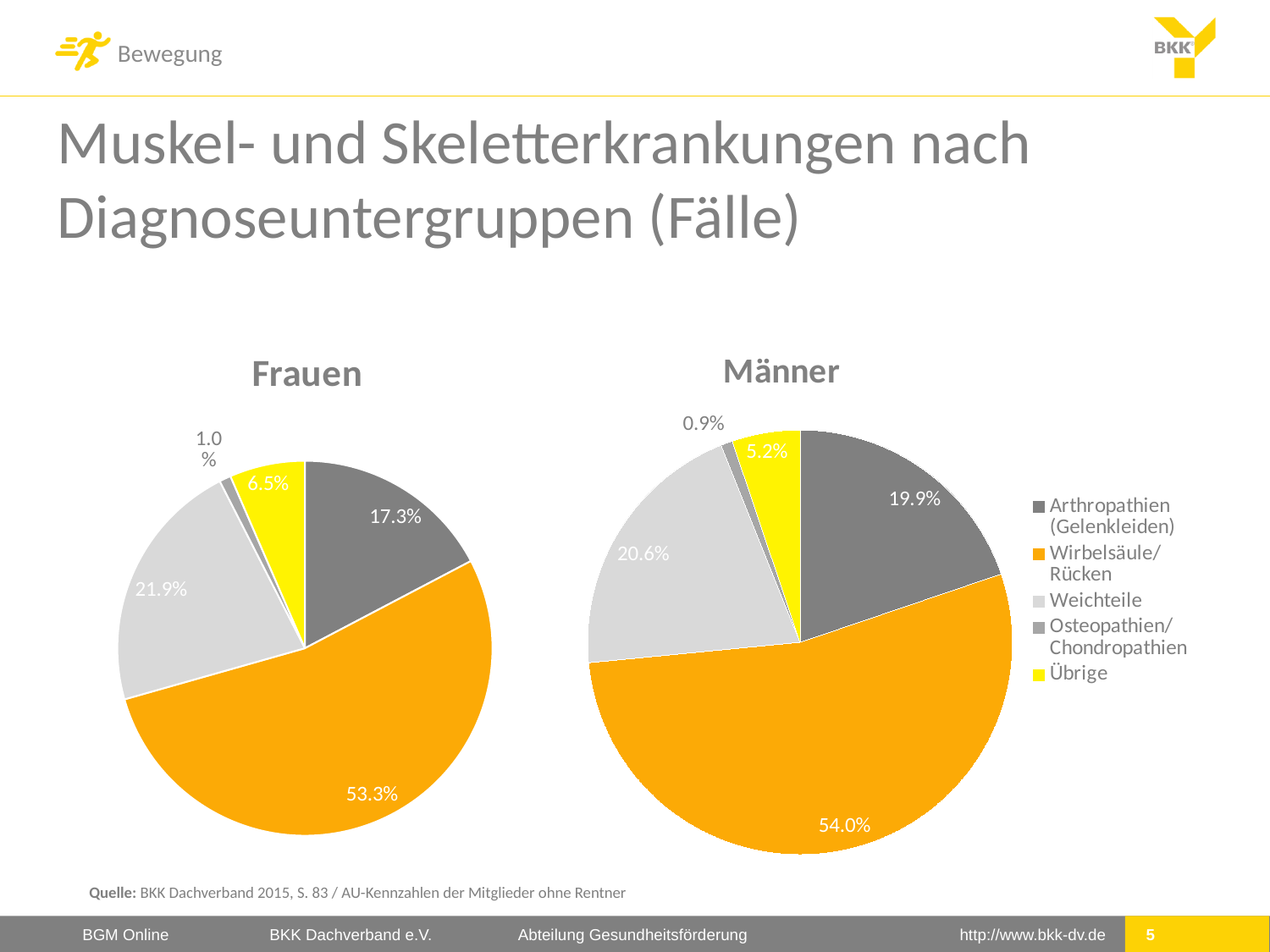
How many entries does the legend list? 5 What type of chart is used for Frauen and Männer on this slide? Pie chart In the Männer pie chart, what share does Arthropathien (Gelenkleiden) have? 19.9% In the Frauen pie chart, what is the difference between the Weichteile share and the Arthropathien (Gelenkleiden) share? 4.6% How many slices does the Männer pie chart have? 5 In the Männer pie chart, which category has the smallest share? Osteopathien/Chondropathien In the Männer pie chart, what share does Weichteile have? 20.6% Is the Übrige share larger in the Frauen chart or in the Männer chart? Frauen In the Frauen pie chart, which category has the largest share? Wirbelsäule/Rücken In the Frauen pie chart, what share does Wirbelsäule/Rücken have? 53.3% In the Frauen pie chart, what share does Übrige have? 6.5% Which colour represents Übrige in the legend? Yellow